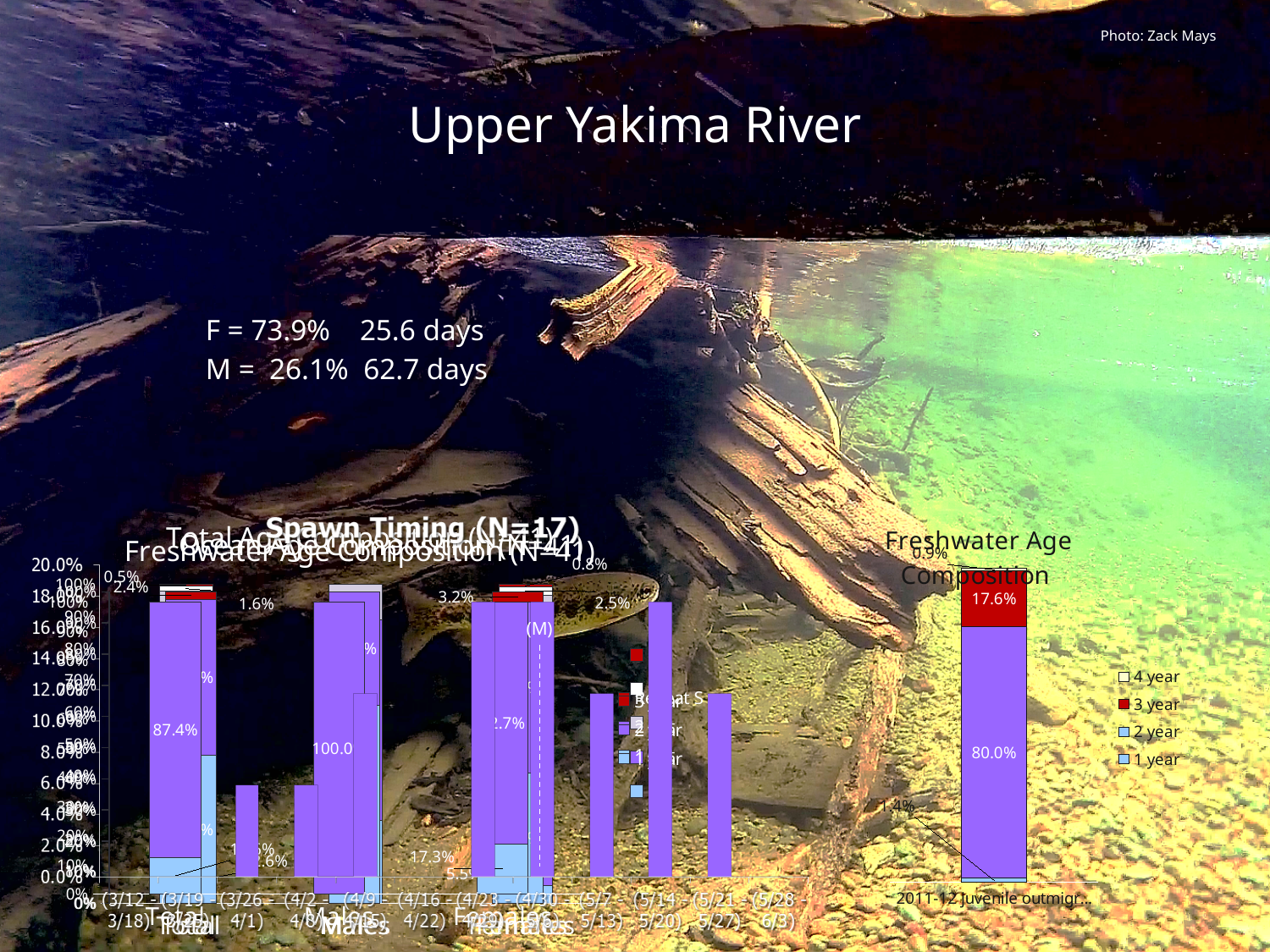
In the Freshwater Age Composition chart on the right, what is the difference between the 3 year share and the 1 year share? 16.2% What sample size (N) is given in the title of the Spawn Timing chart? 17 In the Freshwater Age Composition chart on the right, which age class has the smallest share? 4 year In the Freshwater Age Composition chart on the right, which is larger, the 3 year share or the 1 year share? 3 year In the Freshwater Age Composition chart on the right, what percentage is shown for the 2 year segment? 80.0% In the Freshwater Age Composition chart on the right, what percentage is shown for the 4 year segment? 0.9% In the Freshwater Age Composition chart on the right, what percentage is shown for the 1 year segment? 1.4% In the Freshwater Age Composition chart on the right, which age class has the largest share? 2 year What kind of chart is the Freshwater Age Composition chart on the right? Stacked bar chart What is the title of the chart on the right side of the slide? Freshwater Age Composition How many entries does the legend of the Freshwater Age Composition chart on the right list? 4 In the Freshwater Age Composition chart on the right, what percentage is shown for the 3 year segment? 17.6%